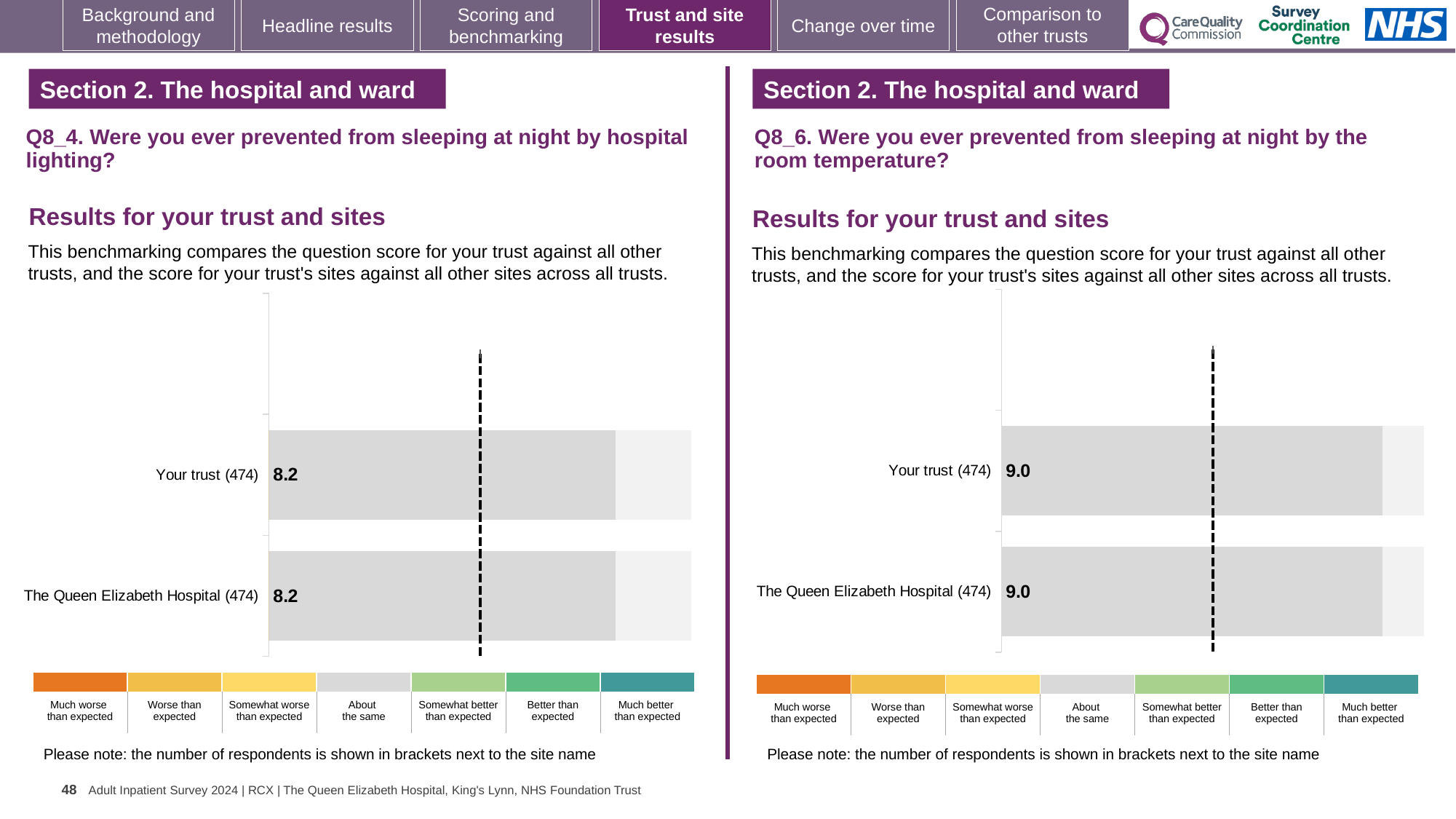
In the left chart (Q8_4), how many respondents are shown in brackets next to Your trust? 474 How many bars are plotted in the right chart (Q8_6)? 2 What kind of chart is used in the left chart (Q8_4)? Bar chart How many rating categories are shown in the colour key below the right chart (Q8_6)? 7 Is the Your trust score higher in the left chart (Q8_4) or the right chart (Q8_6)? Right chart (Q8_6) In the right chart (Q8_6, room temperature), what is the score for Your trust? 9.0 In the right chart (Q8_6, room temperature), what is the score for The Queen Elizabeth Hospital? 9.0 How many bars are plotted in the left chart (Q8_4)? 2 In the left chart (Q8_4), do Your trust and The Queen Elizabeth Hospital have the same score? Yes In the left chart (Q8_4, hospital lighting), what is the score for The Queen Elizabeth Hospital? 8.2 In the left chart (Q8_4, hospital lighting), what is the score for Your trust? 8.2 What is the difference between the Your trust score in the right chart (Q8_6) and the Your trust score in the left chart (Q8_4)? 0.8